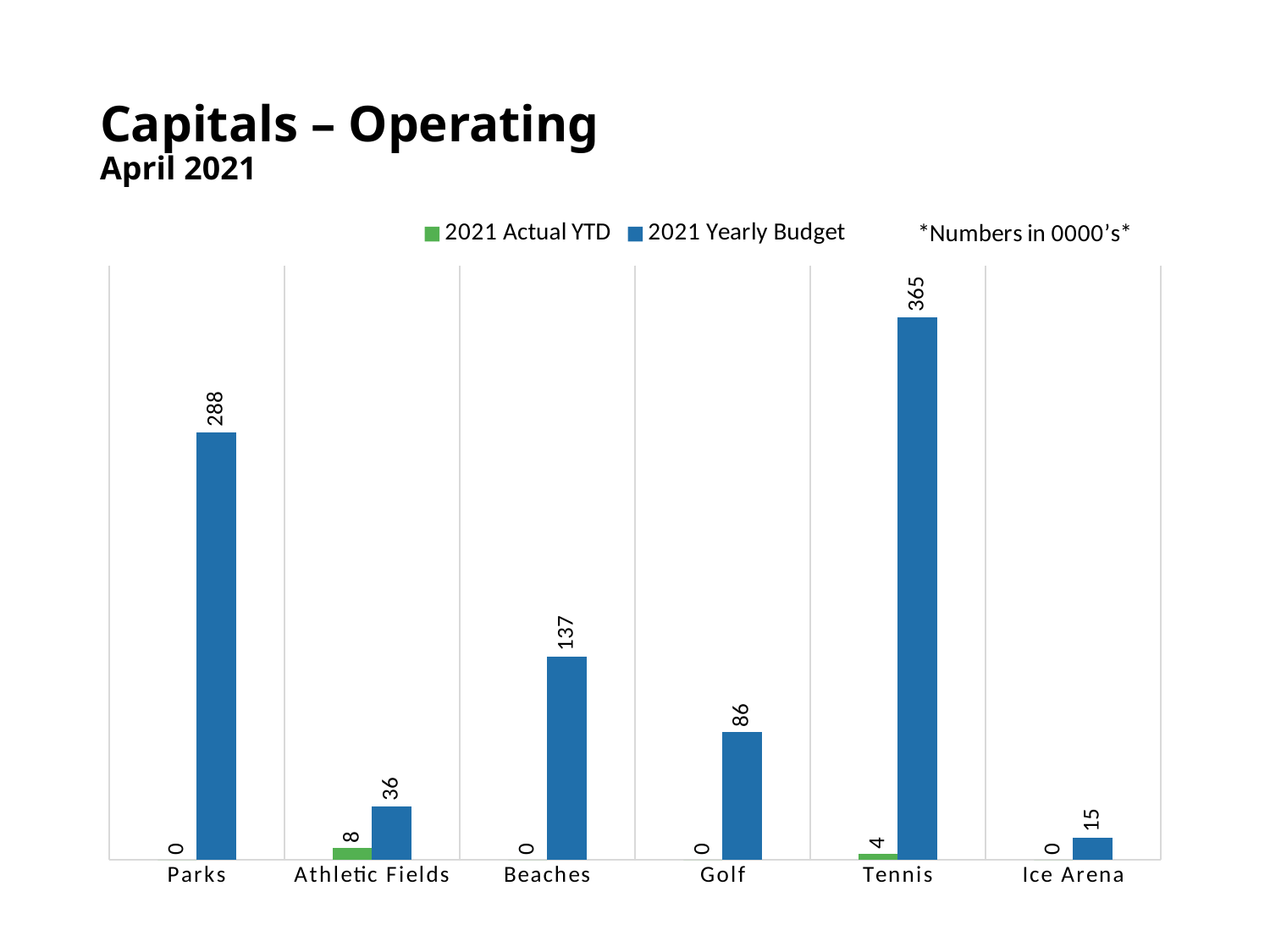
How many categories are shown on the x axis? 6 Which category has the highest 2021 Yearly Budget? Tennis What is the 2021 Actual YTD value for Athletic Fields? 8 What kind of chart is shown on the slide? Bar chart What is the 2021 Yearly Budget value for Parks? 288 Which category has the lowest 2021 Yearly Budget? Ice Arena Which is larger, the 2021 Yearly Budget for Beaches or for Golf? Beaches What is the difference between the 2021 Yearly Budget for Tennis and for Parks? 77 What is the 2021 Yearly Budget value for Ice Arena? 15 What colour represents the 2021 Actual YTD series in the legend? Green How many series does the legend list? 2 What is the 2021 Actual YTD value for Tennis? 4